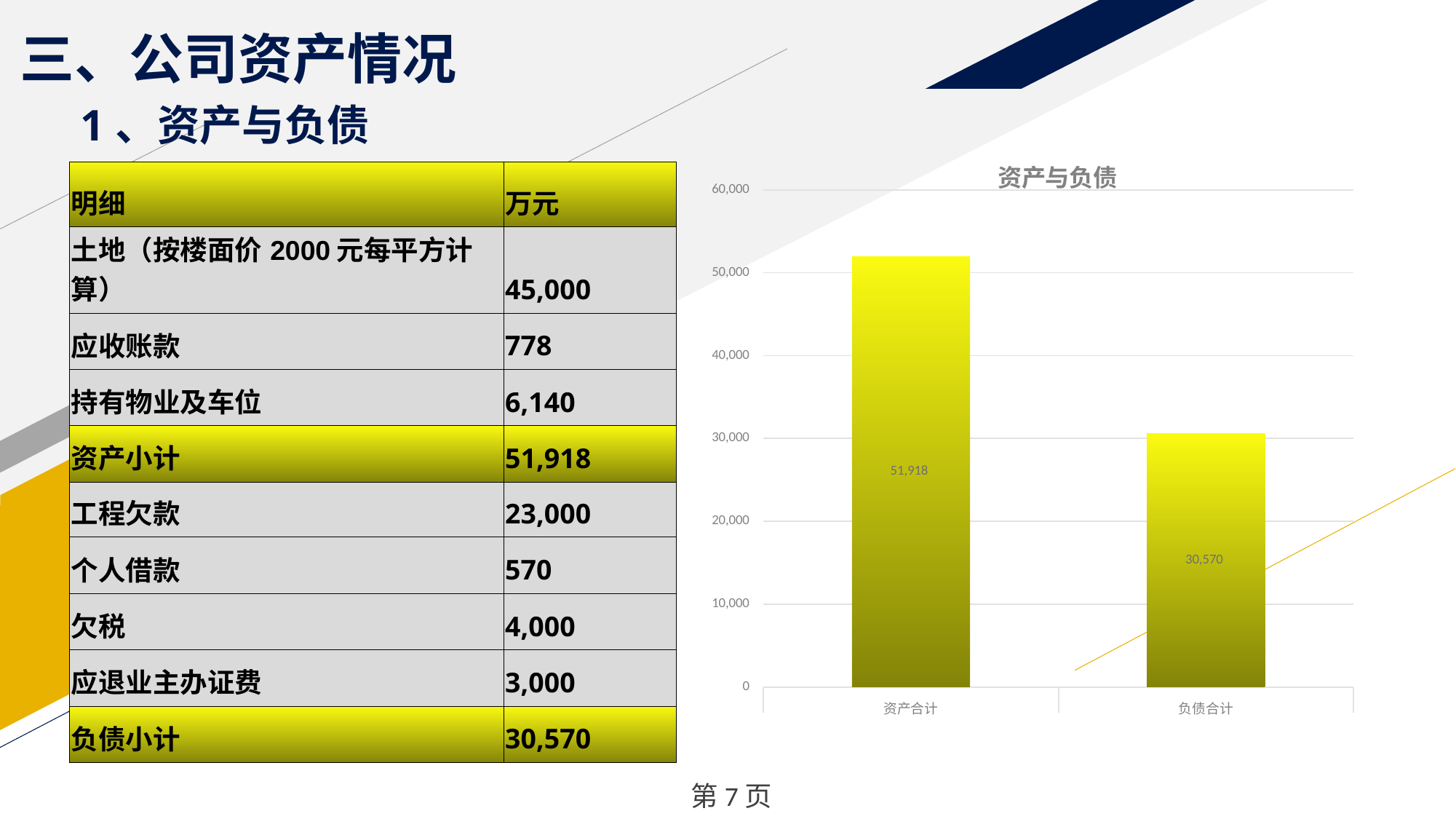
Is the value for 资产合计 greater or less than 50,000? greater What kind of chart is shown on the slide? bar chart Which is larger, 资产合计 or 负债合计? 资产合计 How many categories are shown in the chart? 2 Which category has the lowest value in the chart? 负债合计 Which category has the highest value in the chart? 资产合计 What is the highest value shown on the chart's vertical axis? 60,000 What is the value for 负债合计 in the chart? 30,570 What is the title of the chart? 资产与负债 What is the difference between the values for 资产合计 and 负债合计? 21,348 Is the value for 负债合计 greater or less than 40,000? less What is the value for 资产合计 in the chart? 51,918